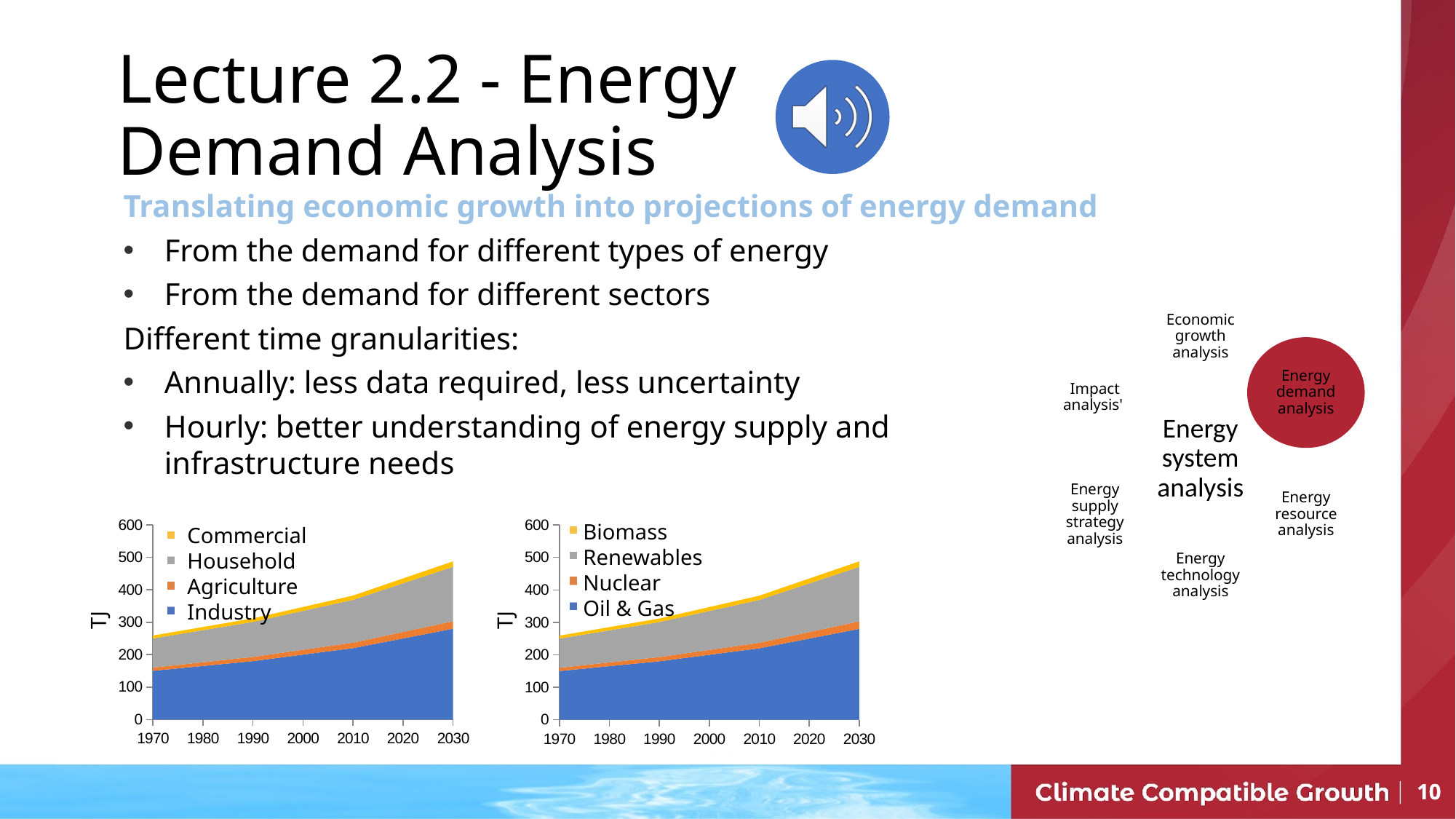
In the left chart, does the total energy demand rise or fall from 1970 to 2030? rise What kind of chart is the left chart (with Commercial, Household, Agriculture, Industry)? stacked area chart How many series does the legend of the left chart list? 4 How many series does the legend of the right chart list? 4 In the left chart, is the total demand in 1970 greater or less than 300? less In the right chart, which energy type accounts for the smallest share of demand? Biomass In the right chart, is the Oil & Gas value in 1970 greater or less than 200? less In the left chart, which sector accounts for the largest share of demand? Industry In the right chart, does the Oil & Gas demand rise or fall from 1970 to 2030? rise What is the y-axis label on the left chart? TJ In the right chart, which series are listed in the legend? Biomass, Renewables, Nuclear, Oil & Gas In the left chart, is the total demand in 2030 greater or less than 400? greater